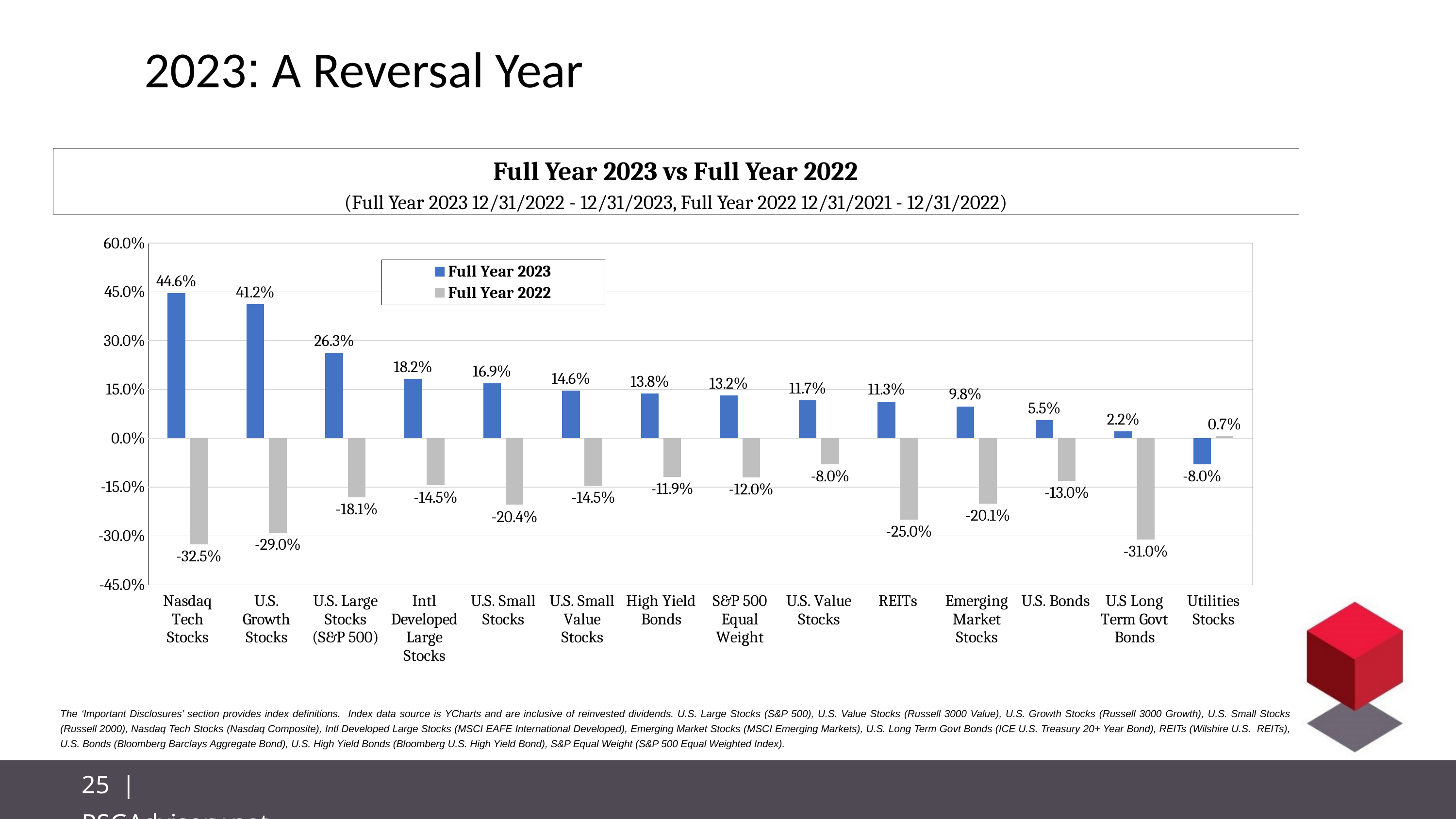
What kind of chart is shown on the slide? Bar chart Which category has the lowest Full Year 2023 value? Utilities Stocks How many series does the legend list? 2 What is the Full Year 2022 value for U.S Long Term Govt Bonds? -31.0% Do the Full Year 2023 values rise or fall from Nasdaq Tech Stocks to Utilities Stocks along the x axis? Fall How many categories are shown on the x axis? 14 Which category has the lowest Full Year 2022 value? Nasdaq Tech Stocks What is the Full Year 2022 value for REITs? -25.0% What is the difference between the Full Year 2023 and Full Year 2022 values for U.S. Large Stocks (S&P 500)? 44.4 percentage points What is the Full Year 2023 value for Nasdaq Tech Stocks? 44.6% Which is larger, the Full Year 2023 value for U.S. Small Stocks or for U.S. Small Value Stocks? U.S. Small Stocks Which category has the highest Full Year 2023 value? Nasdaq Tech Stocks